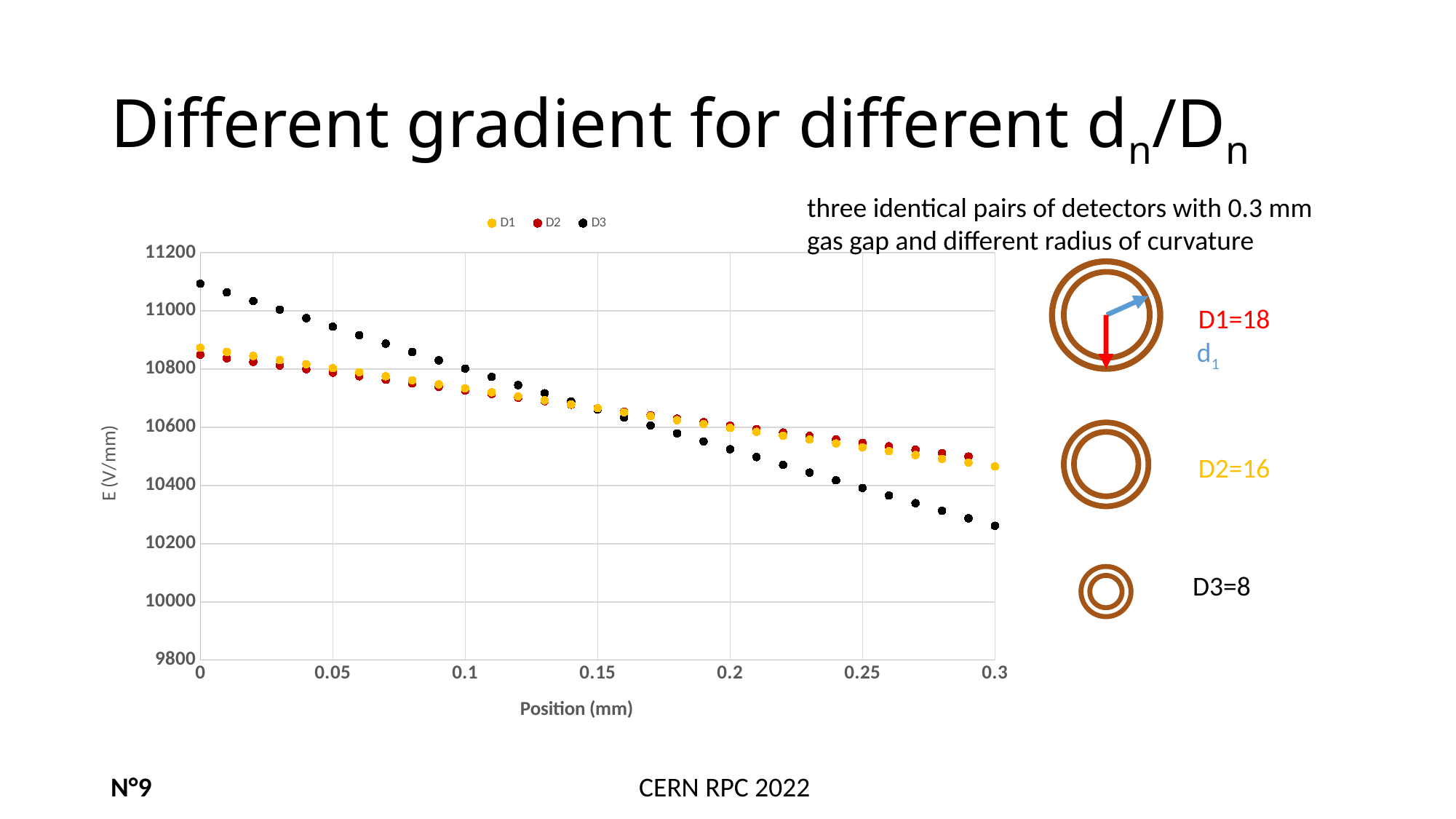
At position 0.3, which series has the larger value, D1 or D3? D1 What is the label of the y axis of the chart? E (V/mm) Is the value of D2 at position 0.3 greater or less than 10600? less At position 0, which series has the larger value, D1 or D3? D3 Do the values of the D3 series rise or fall as position increases along the x axis? fall Is the value of D1 at position 0 greater or less than 10800? greater Is the value of D3 at position 0 greater or less than 11000? greater What type of chart is shown on the slide? scatter chart What are the names of the series listed in the chart legend? D1, D2, D3 How many series does the legend of the chart list? 3 Which series has the lowest value at position 0.3? D3